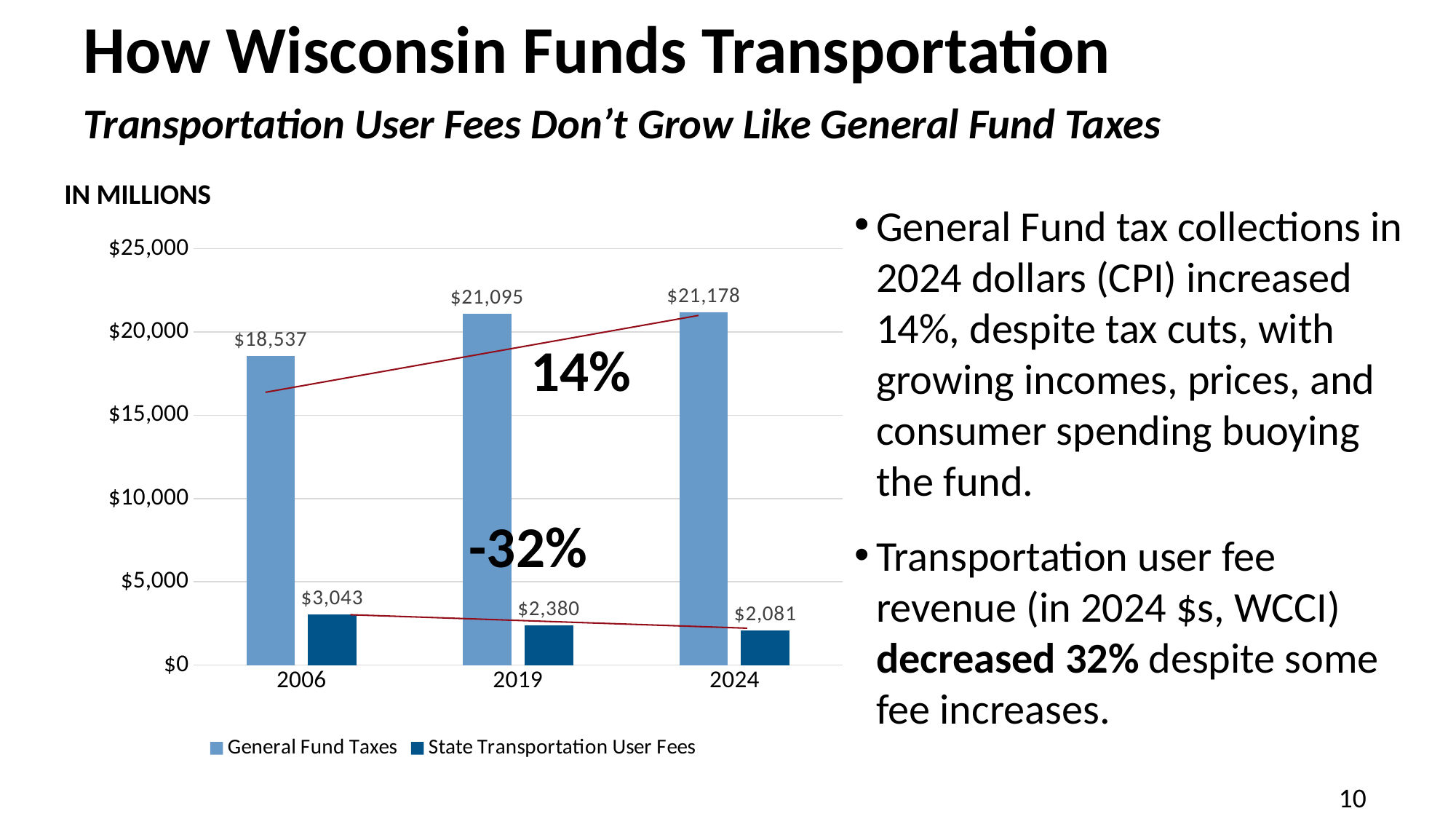
Which is larger: State Transportation User Fees in 2006 or in 2019? 2006 What is the difference between General Fund Taxes in 2024 and in 2006? $2,641 How many series does the legend list? 2 What kind of chart is shown on the slide? Bar chart What is the value of State Transportation User Fees in 2019? $2,380 How many years are shown on the x axis? 3 In which year are General Fund Taxes highest? 2024 What is the value of State Transportation User Fees in 2024? $2,081 In which year are State Transportation User Fees lowest? 2024 Is the value for General Fund Taxes in 2019 greater or less than $20,000? greater What is the value of General Fund Taxes in 2006? $18,537 What is the difference between State Transportation User Fees in 2006 and in 2024? $962